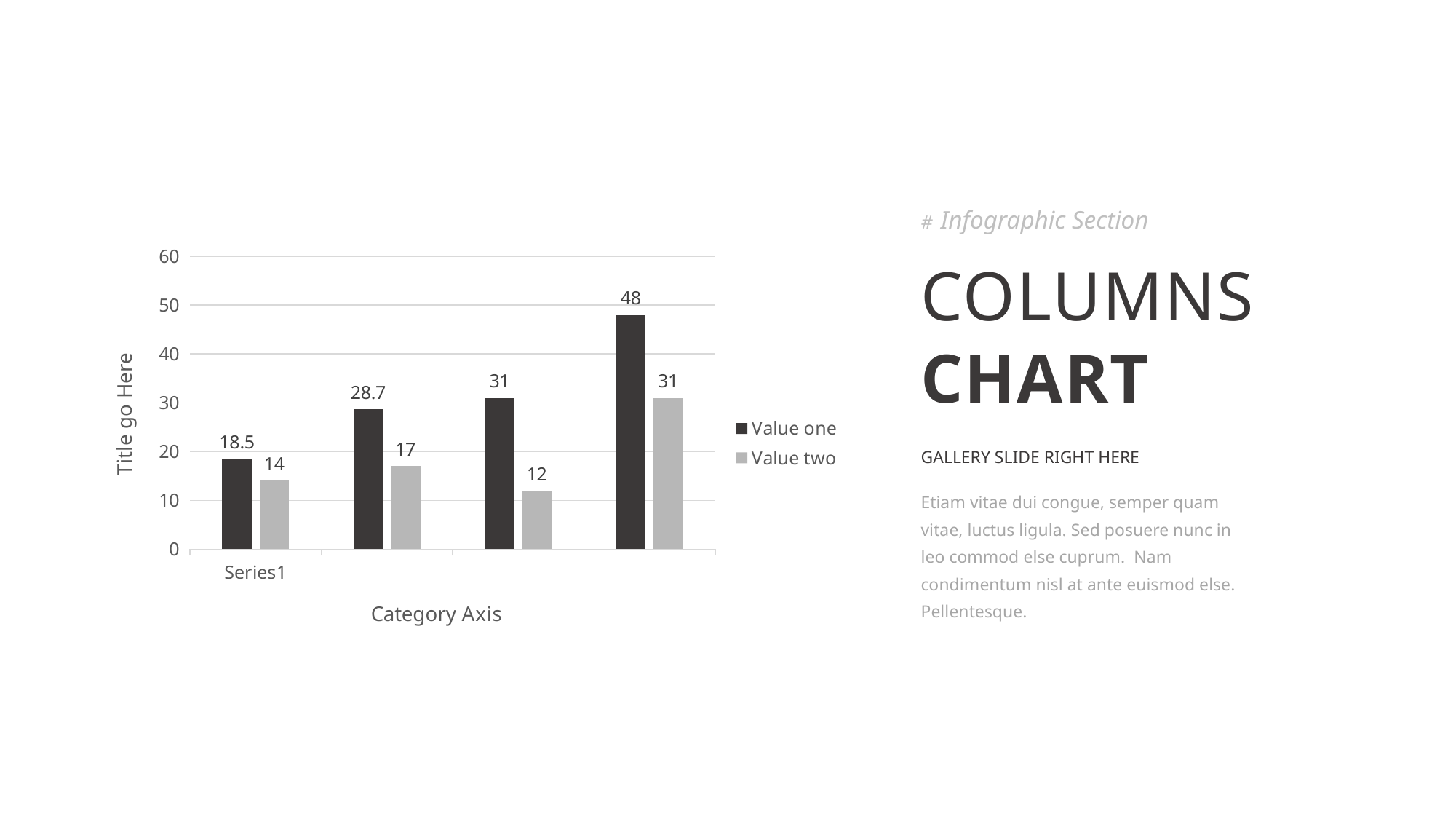
For Series1, which is larger, Value one or Value two? Value one What is the highest value plotted for the Value two series? 31 What is the value of Value one for Series1? 18.5 How many series does the legend list? 2 How many groups of bars are plotted on the chart? 4 What is the lowest value plotted for the Value two series? 12 What is the difference between Value one and Value two for Series1? 4.5 Is the value of Value one for Series1 greater or less than 20? less What is the title of the vertical axis? Title go Here What type of chart is shown on the slide? bar chart What is the highest value plotted for the Value one series? 48 What is the value of Value two for Series1? 14